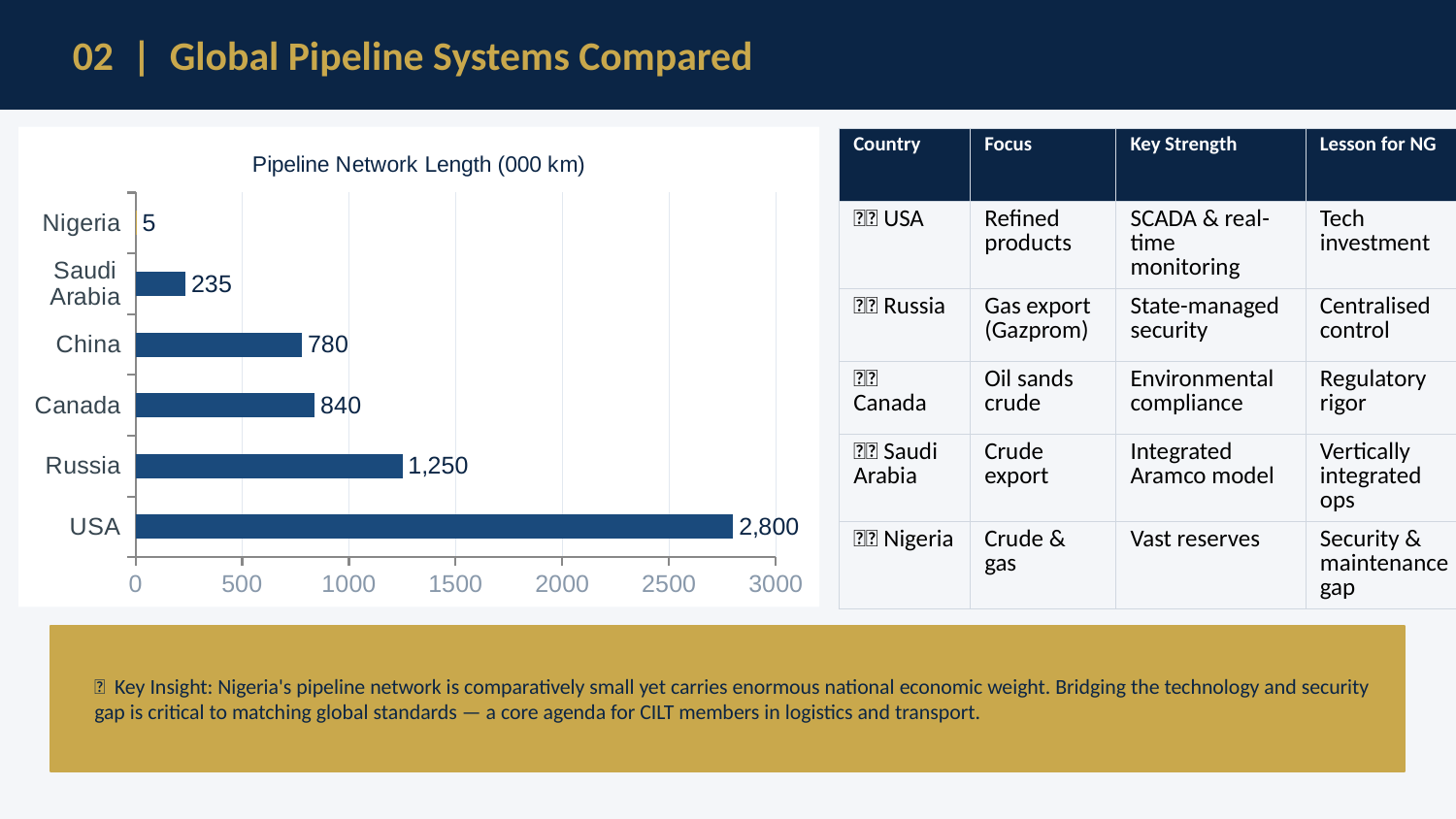
What is the pipeline network length for Saudi Arabia? 235 What is the difference between the pipeline network lengths of the USA and Nigeria? 2,795 What is the pipeline network length for the USA? 2,800 What type of chart is shown on the slide? Bar chart What is the difference between the pipeline network lengths of Russia and China? 470 Is the value for Russia greater or less than 1000? greater Which has a longer pipeline network, Canada or China? Canada What is the pipeline network length for Canada? 840 How many countries are shown in the chart? 6 What is the title of the chart? Pipeline Network Length (000 km) Which country has the longest pipeline network? USA Which country has the shortest pipeline network? Nigeria